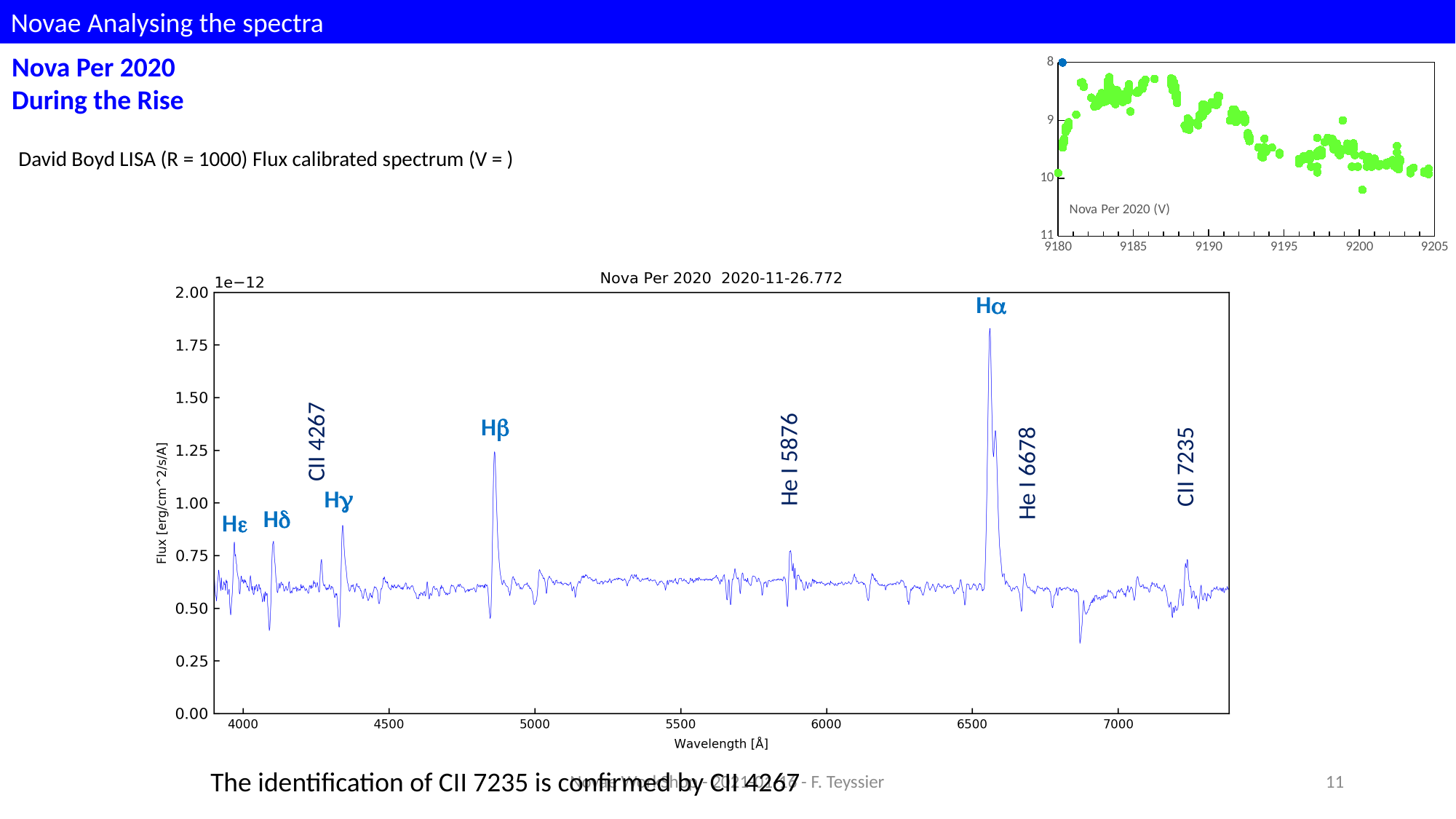
What is the title of the main spectrum chart? Nova Per 2020 2020-11-26.772 In the main spectrum chart, which labelled emission line has the highest peak flux? Hα In the main spectrum chart, is the peak flux of Hα greater or less than 1.50 (×1e−12)? greater What kind of chart is the main spectrum plot? line chart In the main spectrum chart, is the peak flux of Hγ greater or less than 1.00 (×1e−12)? less What is the label shown inside the light curve chart at the top right? Nova Per 2020 (V) How many spectral lines are labelled on the main spectrum chart? 9 In the main spectrum chart, which has the higher peak flux, Hβ or Hγ? Hβ In the main spectrum chart, what is the x-axis label? Wavelength [Å] In the main spectrum chart, is the peak flux of Hβ greater or less than 1.50 (×1e−12)? less In the main spectrum chart, which has the higher peak flux, Hα or Hβ? Hα